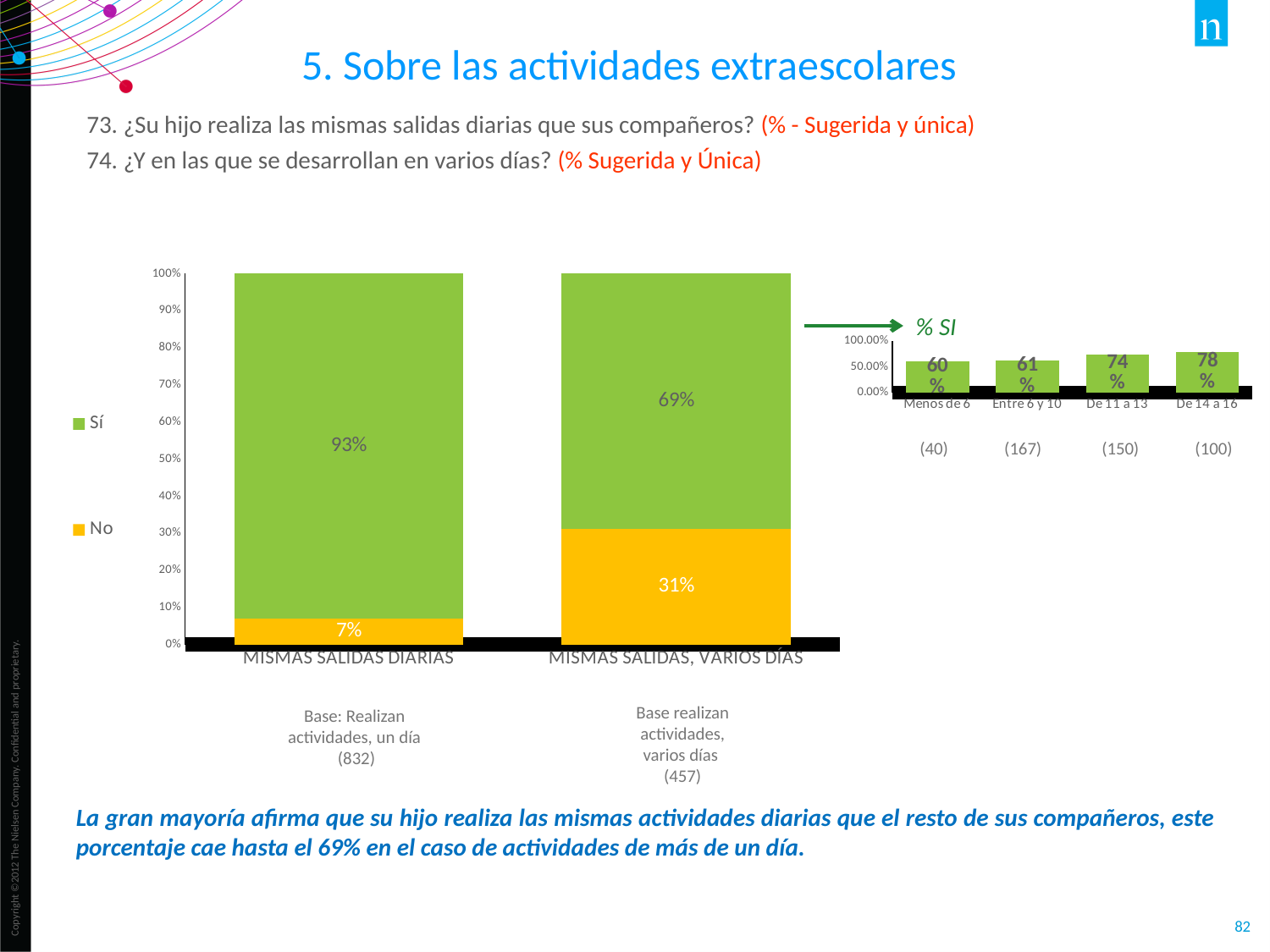
In the small '% SI' chart on the right, do the values rise or fall from Menos de 6 to De 14 a 16? Rise In the large stacked bar chart, what is the difference between the 'Sí' values for MISMAS SALIDAS DIARIAS and MISMAS SALIDAS, VARIOS DÍAS? 24 percentage points In the small '% SI' chart on the right, what is the difference between the values for De 14 a 16 and Menos de 6? 18 percentage points In the large stacked bar chart, what is the 'No' value for MISMAS SALIDAS, VARIOS DÍAS? 31% In the large stacked bar chart, what is the 'Sí' value for MISMAS SALIDAS DIARIAS? 93% In the small '% SI' chart on the right, which age group has the highest value? De 14 a 16 In the large stacked bar chart, which category has the larger 'No' share: MISMAS SALIDAS DIARIAS or MISMAS SALIDAS, VARIOS DÍAS? MISMAS SALIDAS, VARIOS DÍAS In the small '% SI' chart on the right, how many age groups are shown? 4 In the large stacked bar chart, what is the 'No' value for MISMAS SALIDAS DIARIAS? 7% What kind of chart is the large chart on the left? Stacked bar chart In the small '% SI' chart on the right, what is the value for De 11 a 13? 74% In the large stacked bar chart, how many series does the legend list? 2